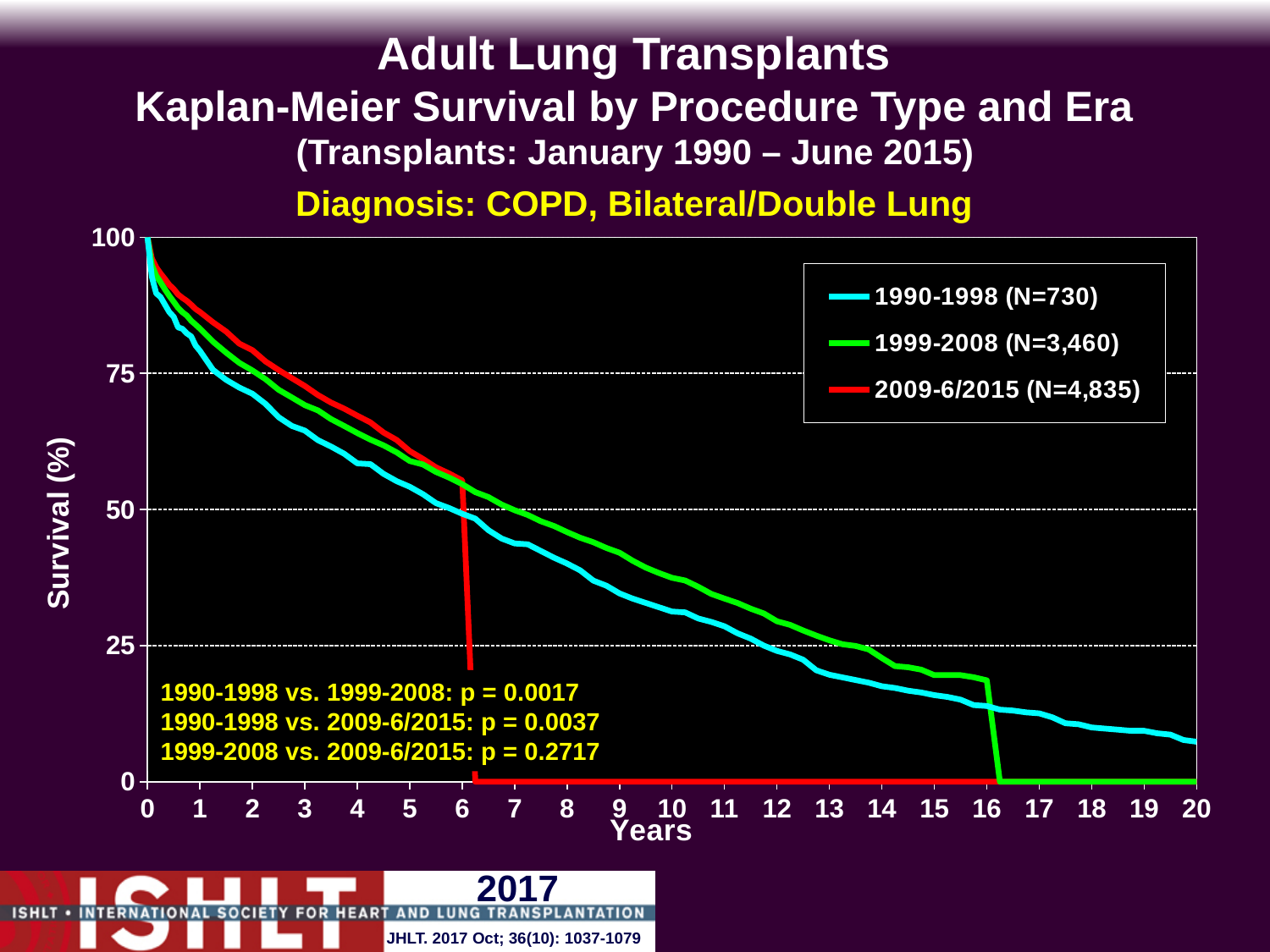
At year 1, which era has the lowest survival? 1990-1998 Is the survival value for the 1990-1998 era at year 10 greater or less than 50? less Is the survival value for the 1990-1998 era at year 10 greater or less than 25? greater At year 10, which era has higher survival: 1990-1998 or 1999-2008? 1999-2008 Do the survival curves rise or fall as years increase? fall What is the N value shown in the legend for the 2009-6/2015 era? 4,835 At year 3, which era has higher survival: 1990-1998 or 2009-6/2015? 2009-6/2015 How many series does the legend list? 3 What kind of chart is shown on the slide? line chart What is the N value shown in the legend for the 1999-2008 era? 3,460 Is the survival value for the 2009-6/2015 era at year 1 greater or less than 75? greater